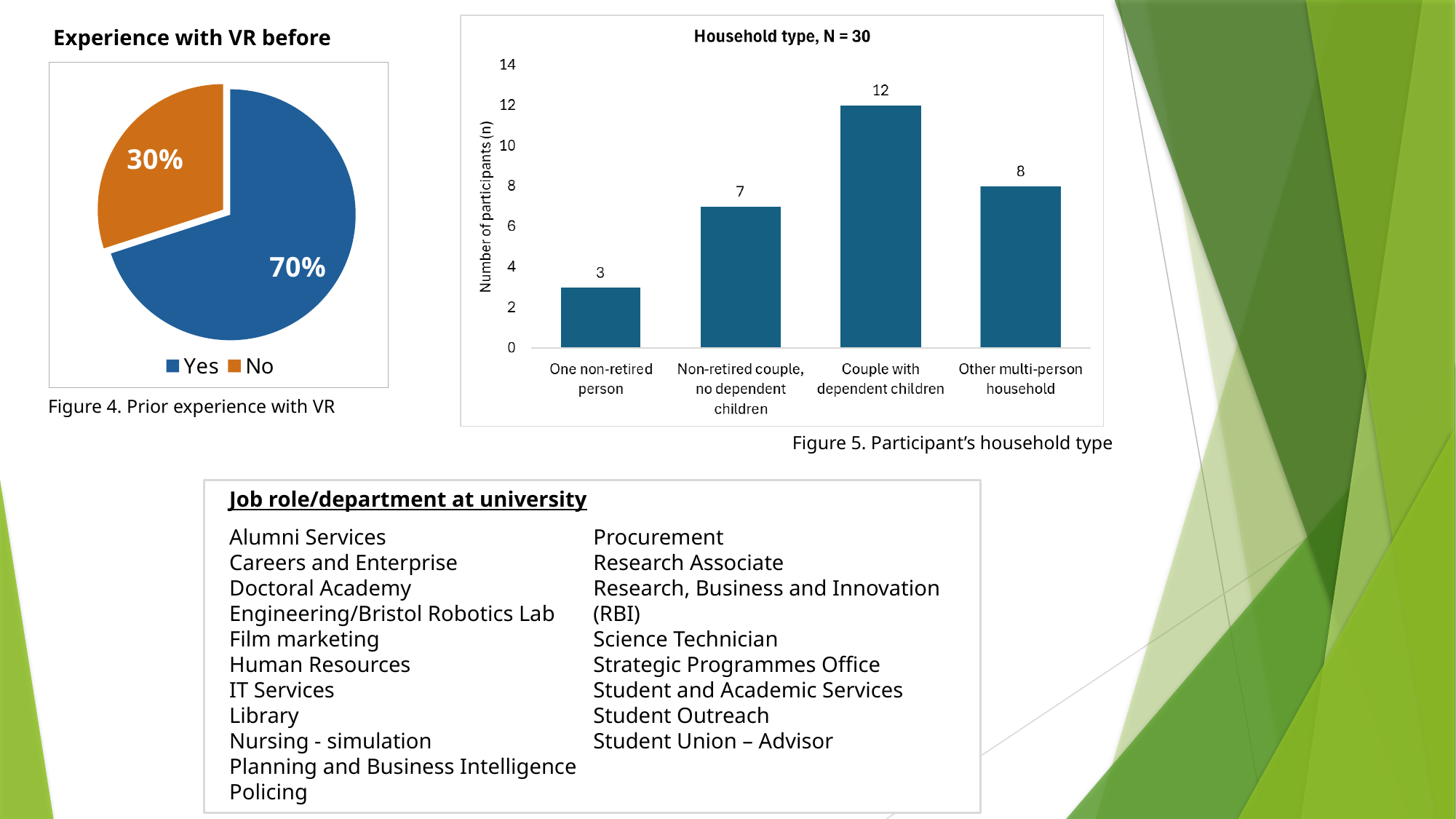
In the 'Experience with VR before' pie chart, which colour represents No? Orange In the 'Experience with VR before' pie chart, what share of participants answered Yes? 70% What kind of chart is the 'Experience with VR before' chart? Pie chart In the 'Household type, N = 30' chart, how many participants are in the 'Couple with dependent children' category? 12 How many categories are shown in the 'Household type, N = 30' bar chart? 4 In the 'Household type, N = 30' chart, which has more participants: 'Non-retired couple, no dependent children' or 'Other multi-person household'? Other multi-person household How many entries does the legend of the 'Experience with VR before' chart list? 2 In the 'Household type, N = 30' chart, what is the difference between 'Couple with dependent children' and 'Other multi-person household'? 4 In the 'Household type, N = 30' chart, how many participants are in the 'One non-retired person' category? 3 In the 'Experience with VR before' pie chart, what share of participants answered No? 30% In the 'Household type, N = 30' chart, which household type has the lowest number of participants? One non-retired person In the 'Household type, N = 30' chart, which household type has the highest number of participants? Couple with dependent children